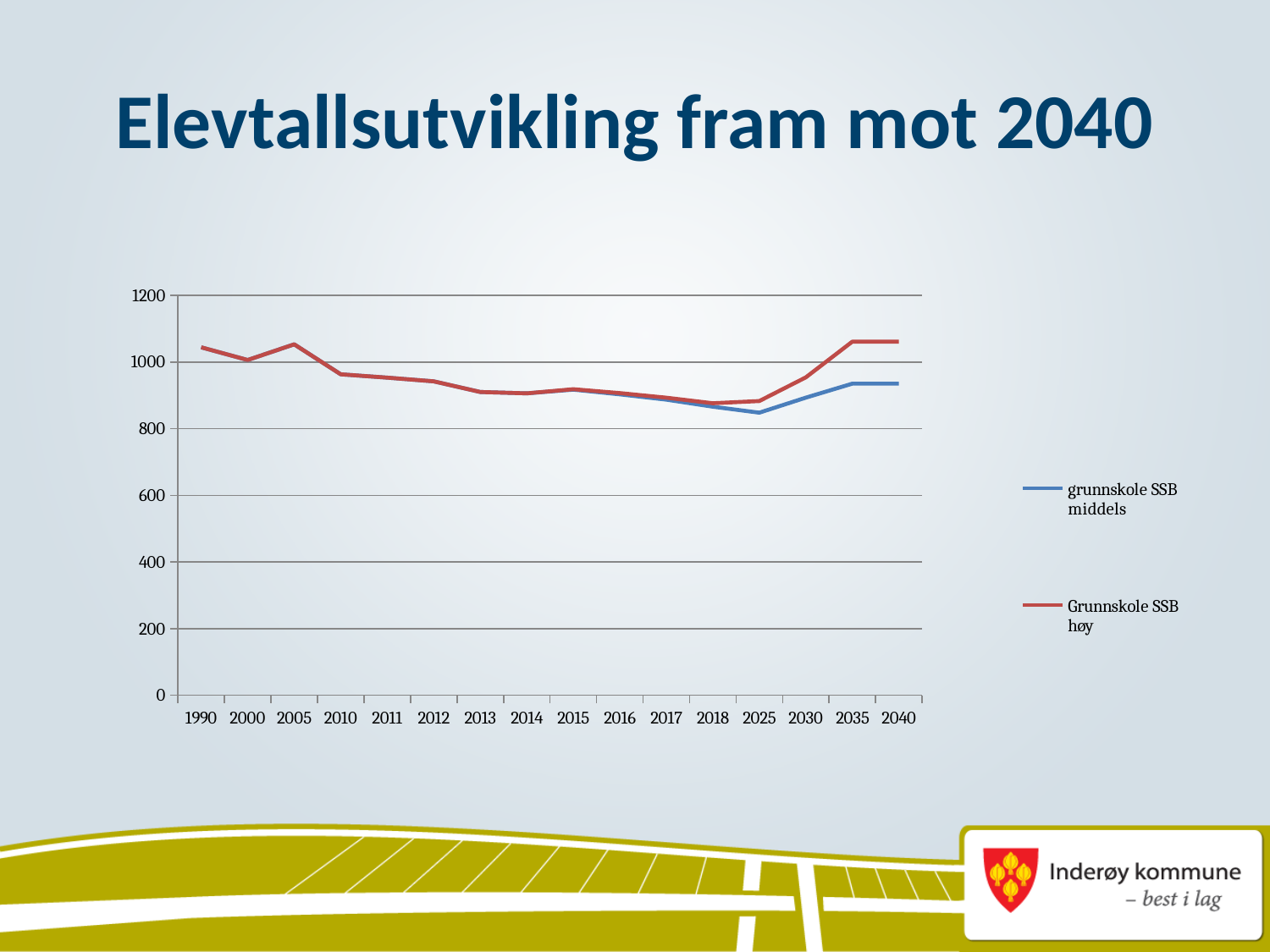
How many series does the legend list? 2 How many years are shown along the x axis? 16 Which colour is used for the 'Grunnskole SSB høy' series? red What kind of chart is shown on the slide? line chart In 2040, which series has the larger value, 'grunnskole SSB middels' or 'Grunnskole SSB høy'? Grunnskole SSB høy Does the 'grunnskole SSB middels' series rise or fall from 2025 to 2040? rise Is the value for 'grunnskole SSB middels' in 2025 greater or less than 800? greater Is the value for 'grunnskole SSB middels' in 2040 greater or less than 1000? less Is the value for 'Grunnskole SSB høy' in 2040 greater or less than 1000? greater What is the title of the slide containing the chart? Elevtallsutvikling fram mot 2040 In which year does the 'grunnskole SSB middels' series reach its lowest value? 2025